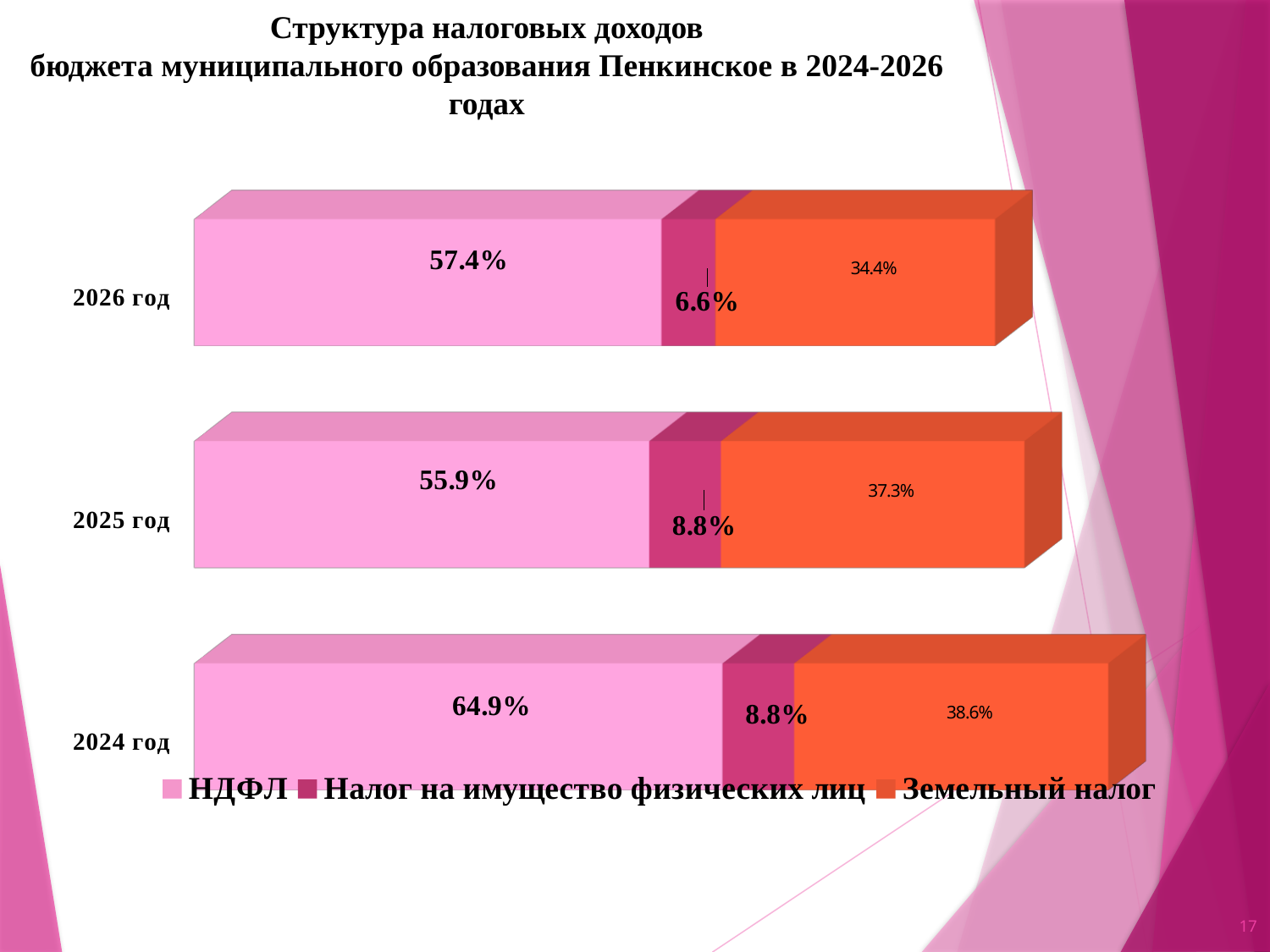
Which is larger: the Земельный налог share in 2024 год or in 2025 год? 2024 год In which year is the share of Налог на имущество физических лиц the lowest? 2026 год What is the share of НДФЛ in 2024 год? 64.9% What type of chart is shown on the slide? Stacked bar chart What is the share of Земельный налог in 2026 год? 34.4% In which year is the share of НДФЛ the highest? 2024 год How many years are shown in the chart? 3 What is the share of Налог на имущество физических лиц in 2026 год? 6.6% What is the share of Земельный налог in 2025 год? 37.3% What is the difference between the НДФЛ share in 2024 год and in 2026 год? 7.5% Does the share of Земельный налог rise or fall from 2024 год to 2026 год? Fall How many series does the legend list? 3